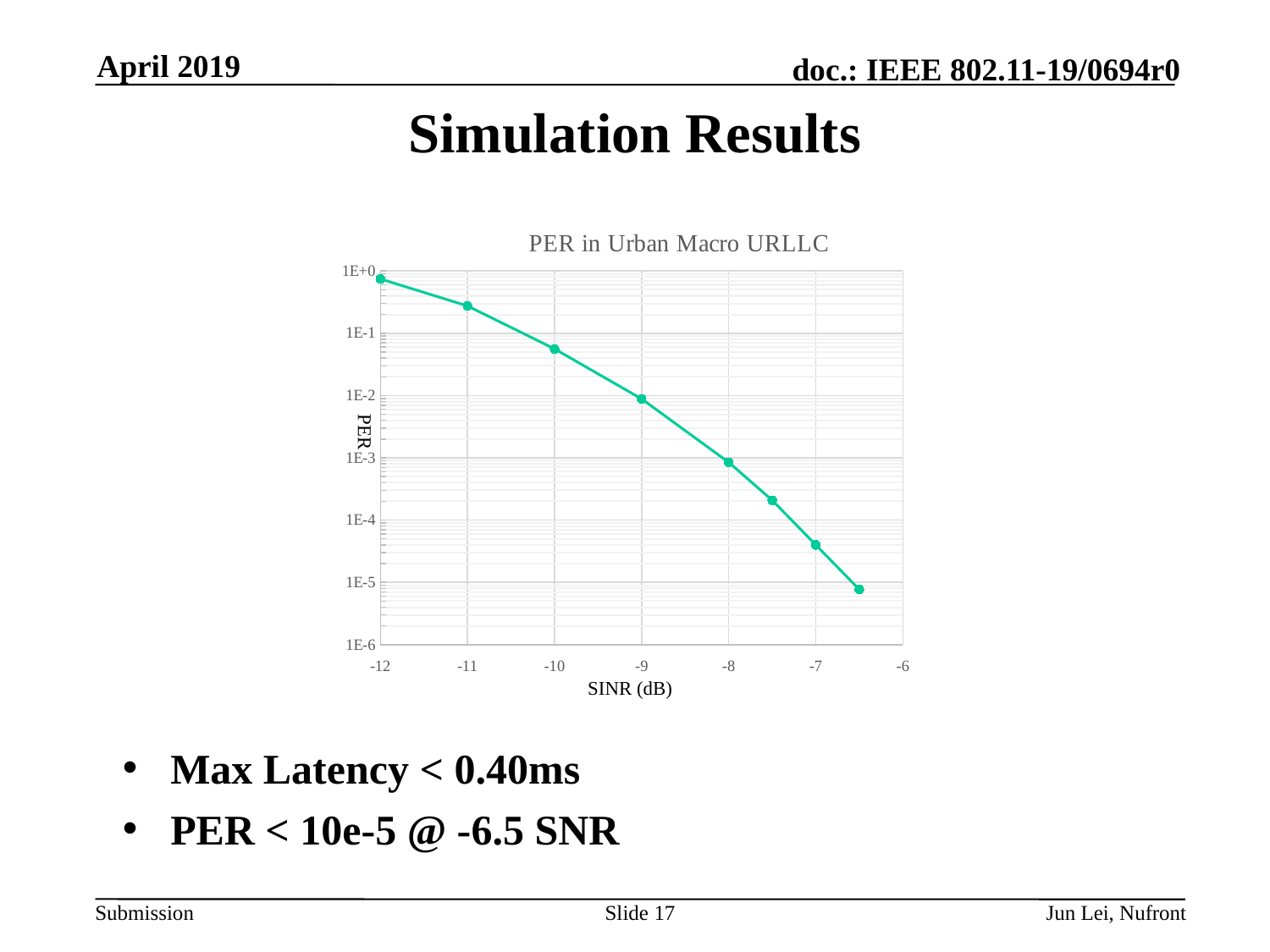
Does PER rise or fall as SINR increases along the x axis? fall How many data points are plotted on the chart? 8 At which SINR value is the PER lowest? -6.5 What is the title of the chart? PER in Urban Macro URLLC At which SINR value is the PER highest? -12 What kind of chart is shown on the slide? line chart Is the PER at -11 dB SINR greater or less than 1E-1? greater Is the PER at -7 dB SINR greater or less than 1E-4? less What is the label of the x axis of the chart? SINR (dB) Is the PER at -10 dB SINR greater or less than 1E-1? less Which has the larger PER: -12 dB SINR or -6.5 dB SINR? -12 dB SINR